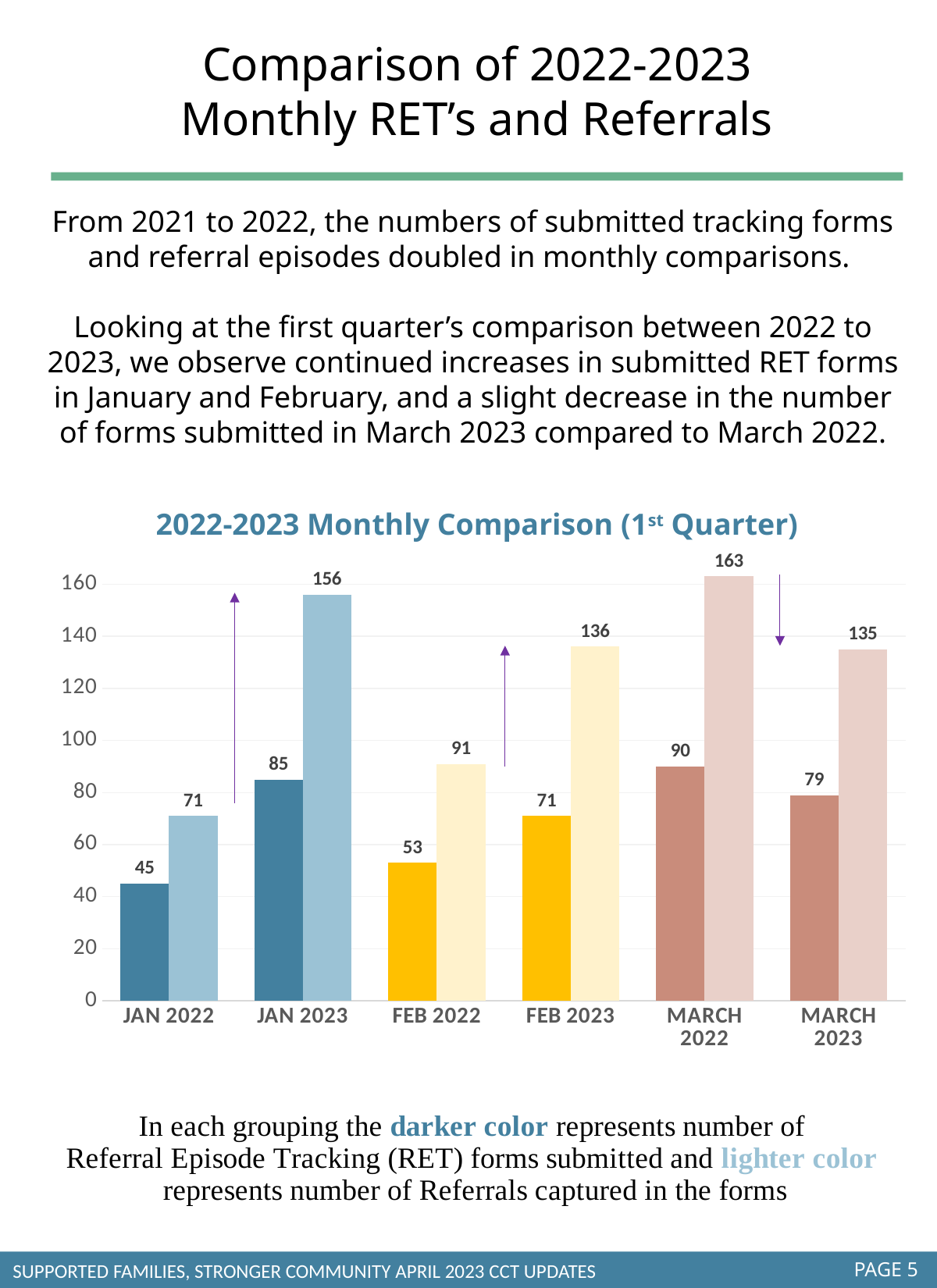
What is the number of Referrals (lighter bar) for FEB 2023? 136 Which month grouping has the highest number of Referrals (lighter bar)? MARCH 2022 What is the number of RET forms submitted (darker bar) for JAN 2023? 85 How many month groupings are shown on the x axis of the chart? 6 Which month grouping has the lowest number of RET forms submitted (darker bar)? JAN 2022 What type of chart is shown on the slide? Bar chart What is the title of the chart on the slide? 2022-2023 Monthly Comparison (1st Quarter) Which is larger: the RET forms (darker bar) for FEB 2023 or for MARCH 2023? MARCH 2023 What is the difference between the RET forms (darker bar) for MARCH 2022 and MARCH 2023? 11 What is the number of Referrals (lighter bar) for MARCH 2022? 163 What is the difference between the Referrals (lighter bar) for JAN 2023 and JAN 2022? 85 What is the number of RET forms submitted (darker bar) for MARCH 2023? 79